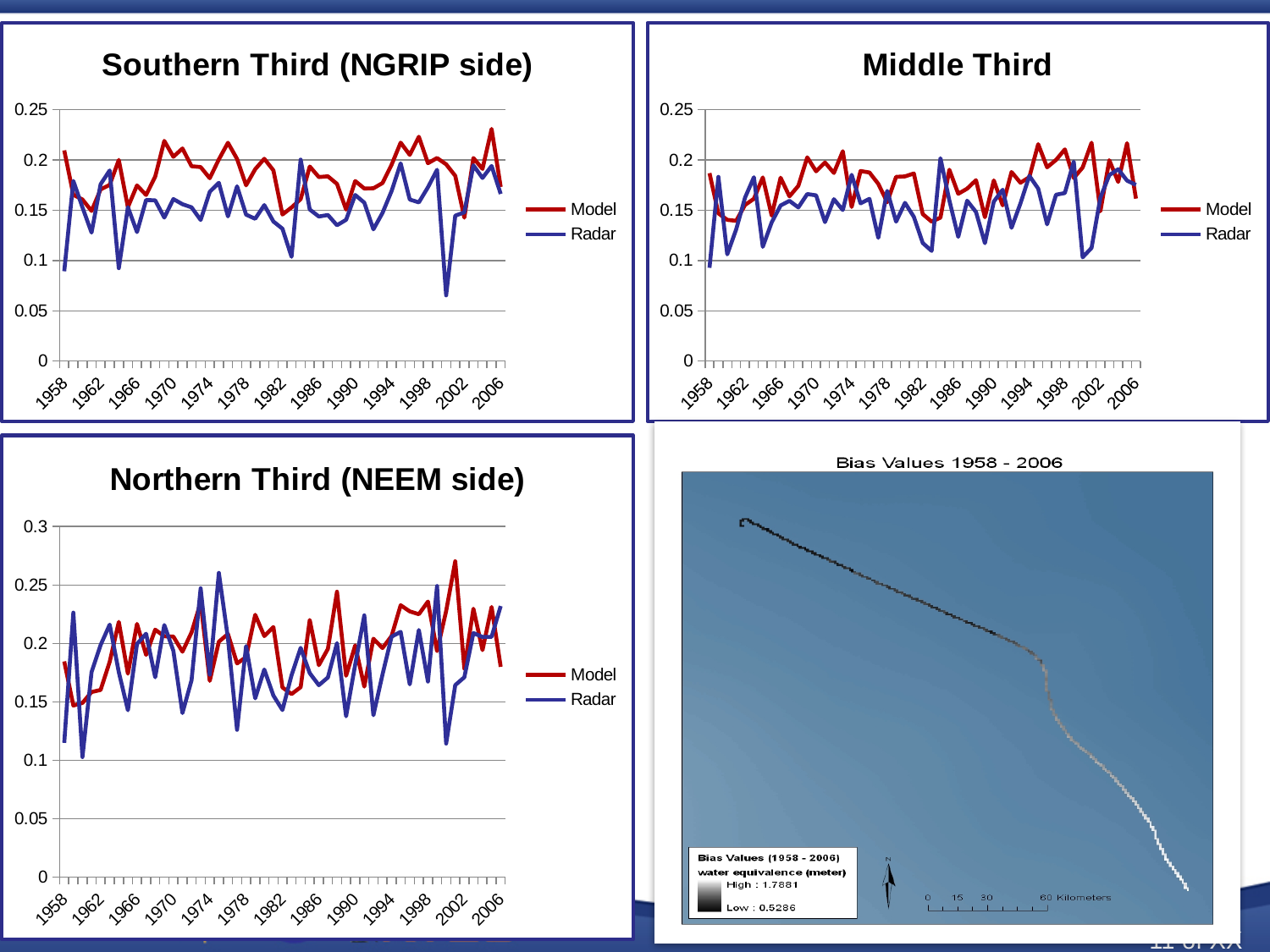
How many series does the legend of the Middle Third chart list? 2 In the Northern Third (NEEM side) chart, around 2001, which series has the larger value, Model or Radar? Model In the Southern Third (NGRIP side) chart, around 2000, which series has the larger value, Model or Radar? Model What kind of chart is the Southern Third (NGRIP side) chart? Line chart In the Southern Third (NGRIP side) chart, is the Radar value around 2000 greater or less than 0.1? less What are the two series named in the legend of the Northern Third (NEEM side) chart? Model and Radar In the Southern Third (NGRIP side) chart, which colour is used for the Radar series? Blue In the Northern Third (NEEM side) chart, is the Radar value around 2000 greater or less than 0.15? less What is the highest value shown on the y axis of the Northern Third (NEEM side) chart? 0.3 In the Southern Third (NGRIP side) chart, is the Model value at 2006 greater or less than 0.2? less What is the first year shown on the x axis of the Middle Third chart? 1958